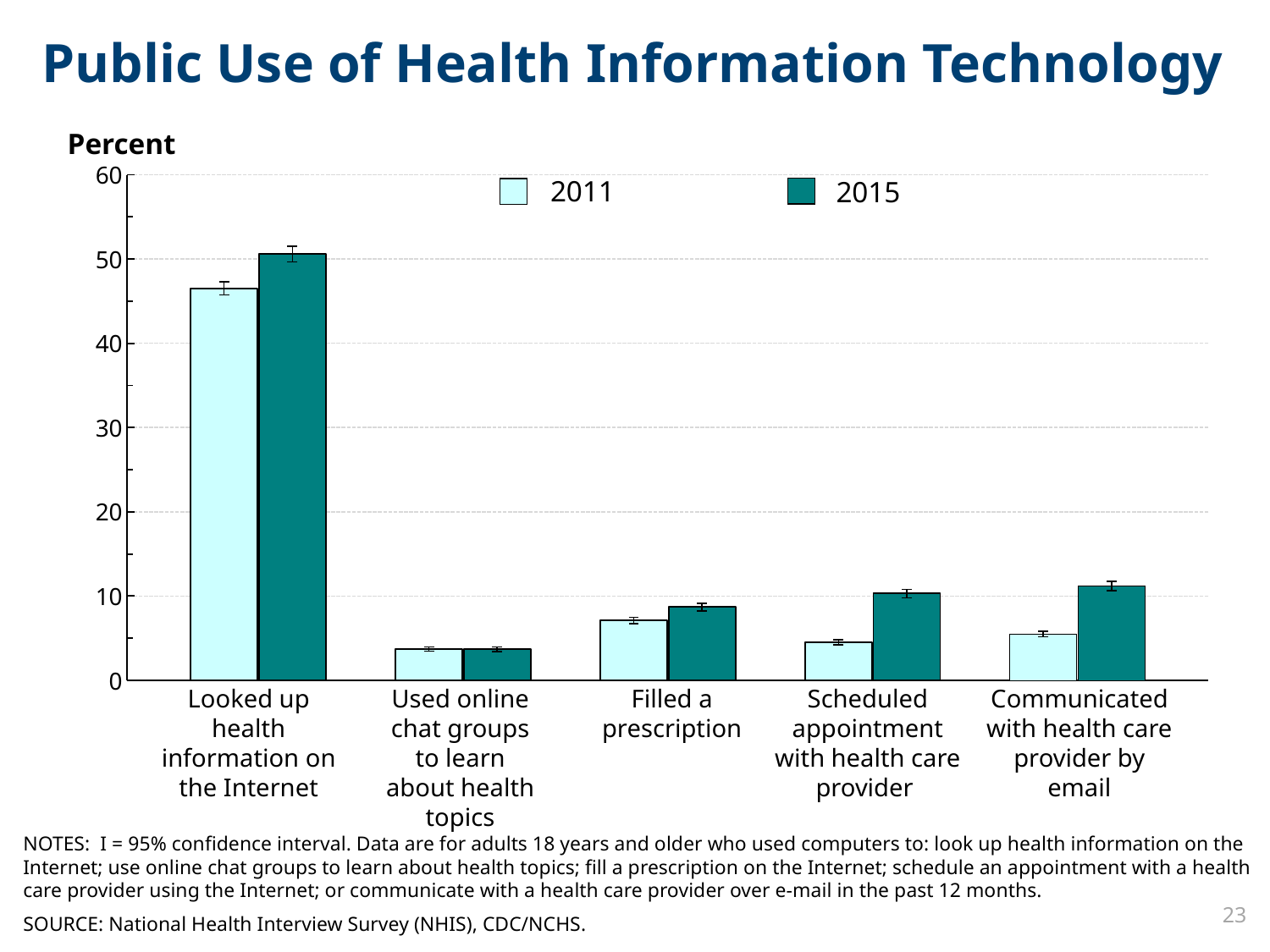
Is the 2015 value for 'Filled a prescription' greater or less than 10? less Is the 2011 value for 'Looked up health information on the Internet' greater or less than 50? less Which category has the highest value for 2015? Looked up health information on the Internet For 2015, which is larger: 'Communicated with health care provider by email' or 'Filled a prescription'? Communicated with health care provider by email How many series does the legend list? 2 What kind of chart is shown on the slide? bar chart Which category has the lowest value for 2011? Used online chat groups to learn about health topics Is the 2011 value for 'Looked up health information on the Internet' greater or less than 40? greater For 'Scheduled appointment with health care provider', which year has the larger value, 2011 or 2015? 2015 What is the label on the y axis of the chart? Percent How many categories of health information technology use are shown on the x axis? 5 Which category has the lowest value for 2015? Used online chat groups to learn about health topics